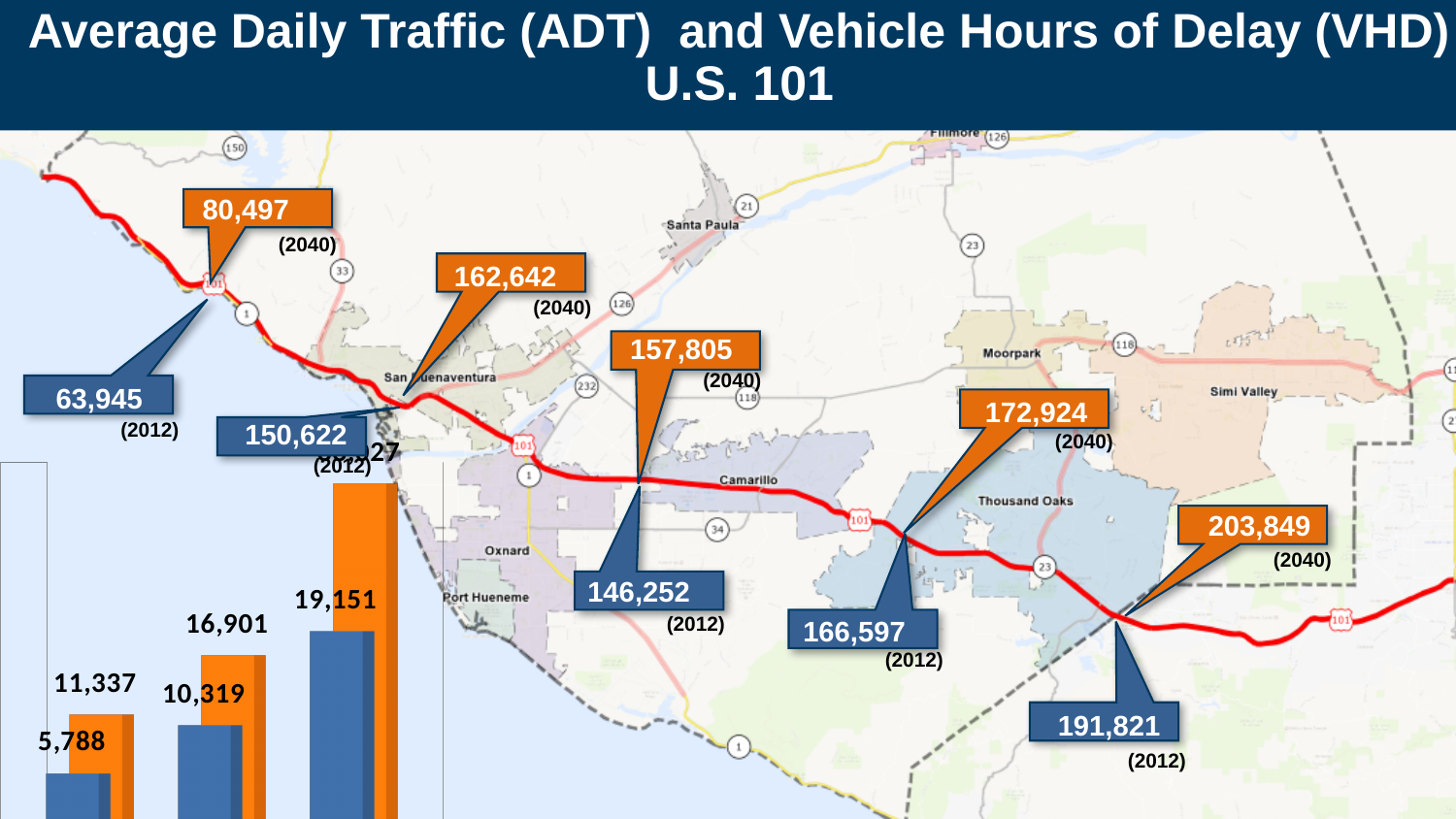
In the bar chart at the lower left, do the blue bars rise or fall from left to right? rise In the bar chart at the lower left, what is the value of the blue bar in the first (leftmost) group? 5,788 In the bar chart at the lower left, what is the value of the orange bar in the first (leftmost) group? 11,337 What kind of chart is shown in the lower-left corner of the slide? bar chart In the bar chart at the lower left, which blue bar is the tallest: the first, second or third group? third group In the bar chart at the lower left, what is the difference between the orange bar and the blue bar in the first group? 5,549 In the bar chart at the lower left, what is the value of the blue bar in the third group? 19,151 In the bar chart at the lower left, how many groups of bars are visible? 3 In the bar chart at the lower left, which blue bar is the shortest: the first, second or third group? first group In the bar chart at the lower left, what is the difference between the orange bar and the blue bar in the second group? 6,582 In the bar chart at the lower left, what is the value of the orange bar in the second group? 16,901 In the bar chart at the lower left, what is the value of the blue bar in the second group? 10,319